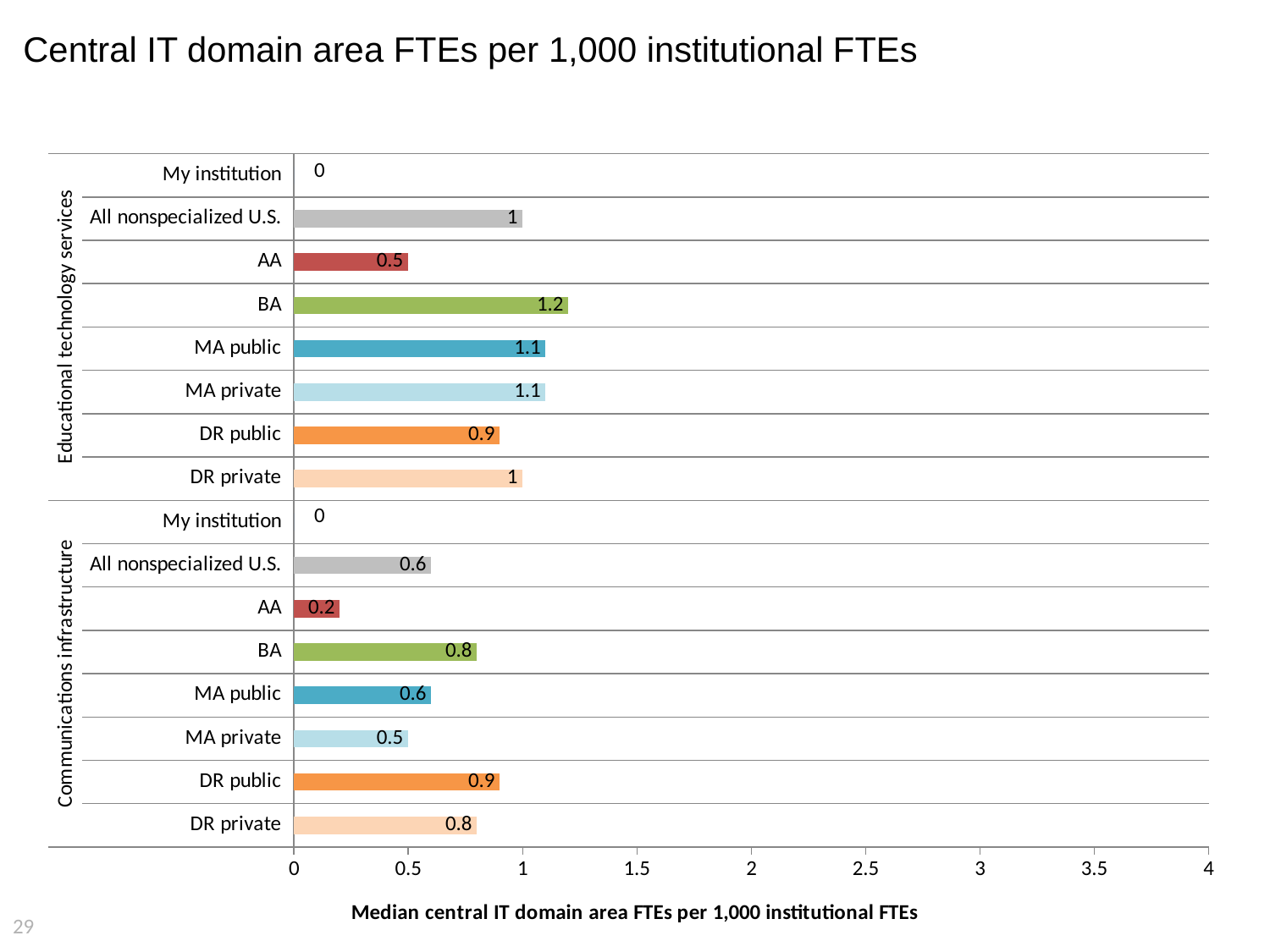
What is the value for All nonspecialized U.S. under Educational technology services? 1 What kind of chart is shown on the slide? Bar chart What is the title of the horizontal axis? Median central IT domain area FTEs per 1,000 institutional FTEs Which category has the highest value under Educational technology services? BA How many bars are plotted under Communications infrastructure? 8 Excluding My institution, which category has the lowest value under Communications infrastructure? AA What is the value for AA under Communications infrastructure? 0.2 What is the difference between the BA values for Educational technology services and Communications infrastructure? 0.4 Which is larger: the DR public value under Communications infrastructure or the MA private value under Communications infrastructure? DR public What is the value for DR public under Communications infrastructure? 0.9 What is the value for BA under Educational technology services? 1.2 Is the value for MA public under Educational technology services greater or less than 1? greater